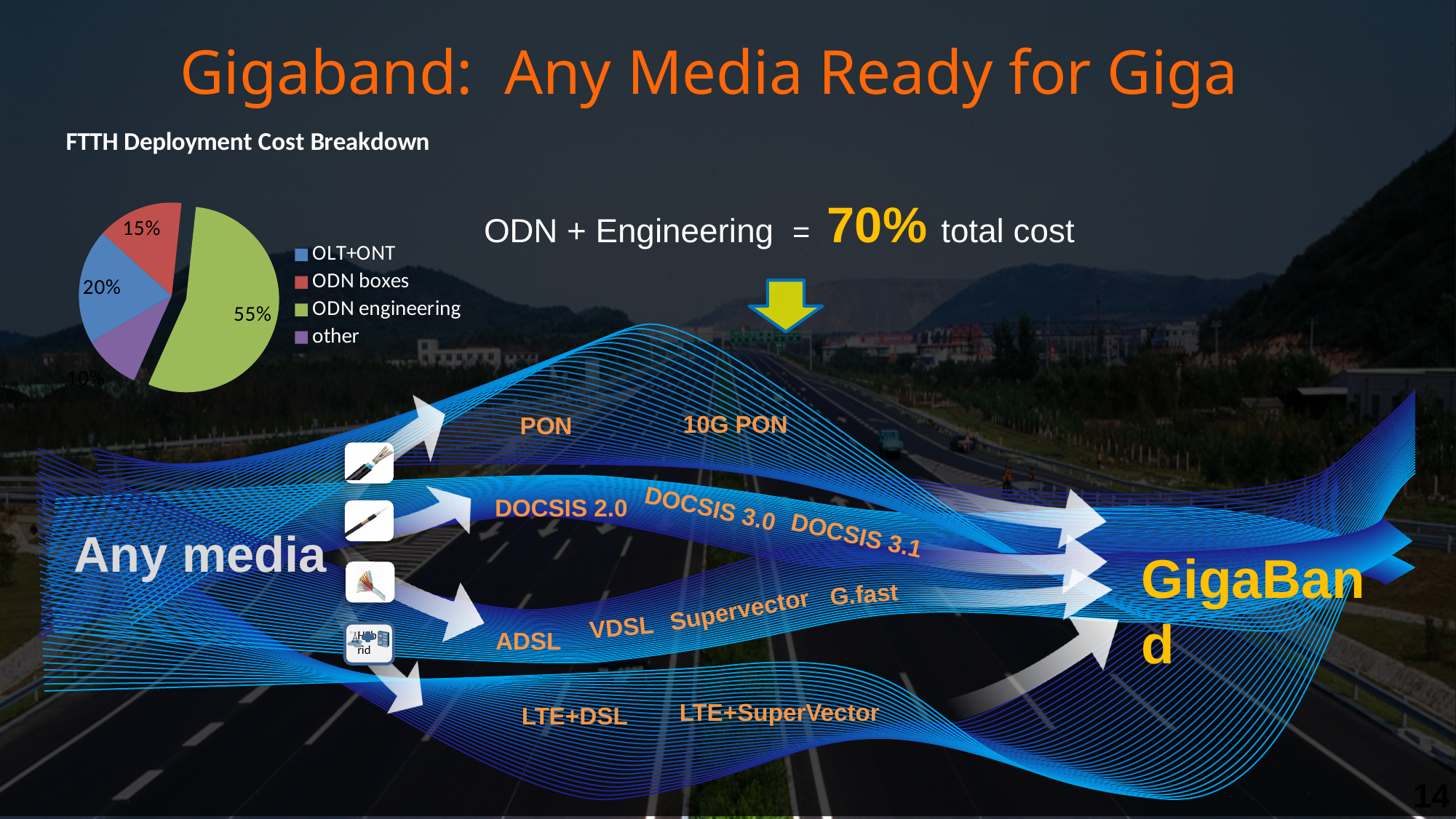
What kind of chart is the FTTH Deployment Cost Breakdown? Pie chart Which is larger in the FTTH Deployment Cost Breakdown: OLT+ONT or ODN boxes? OLT+ONT What is the title of the pie chart? FTTH Deployment Cost Breakdown How many categories does the FTTH Deployment Cost Breakdown pie chart show? 4 Which category has the smallest share of FTTH deployment cost? other What share of FTTH deployment cost is ODN engineering? 55% What is the combined share of ODN boxes and ODN engineering? 70% What is the difference between the ODN engineering share and the OLT+ONT share? 35% What colour is the ODN engineering slice in the pie chart? Green What share of FTTH deployment cost is OLT+ONT? 20% Which category has the largest share of FTTH deployment cost? ODN engineering What share of FTTH deployment cost is ODN boxes? 15%